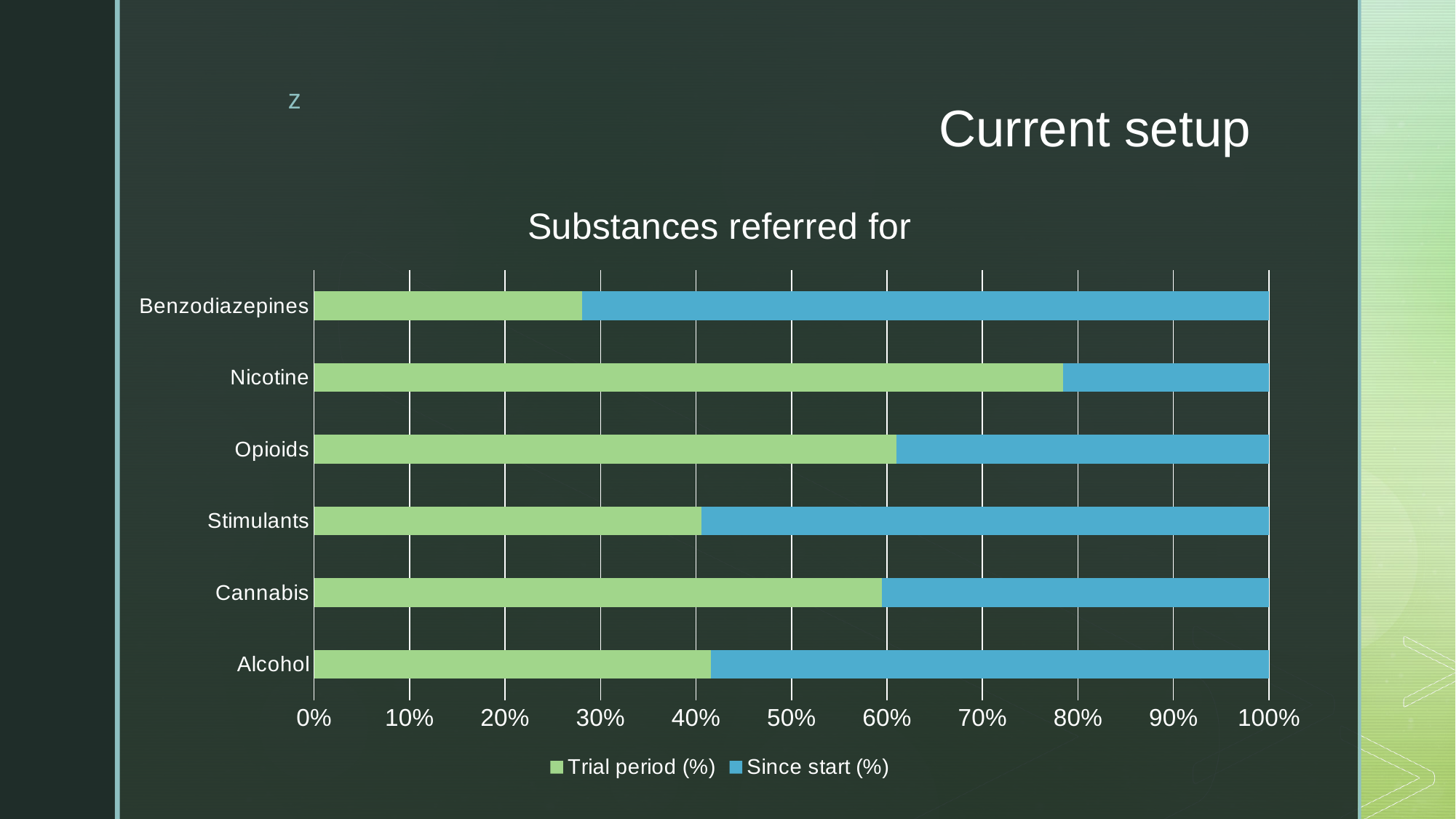
How many series does the legend list? 2 Is the Trial period (%) value for Cannabis greater or less than 50%? greater Is the Trial period (%) value for Stimulants greater or less than 50%? less Which substance has the lowest Trial period (%) share? Benzodiazepines Is the Trial period (%) value for Nicotine greater or less than 70%? greater Which substance has the highest Trial period (%) share? Nicotine How many substance categories are plotted on the chart? 6 What kind of chart is shown on the slide? Stacked bar chart Which has a larger Trial period (%) share, Opioids or Stimulants? Opioids Which colour represents the 'Since start (%)' series? Blue What is the title of the chart? Substances referred for